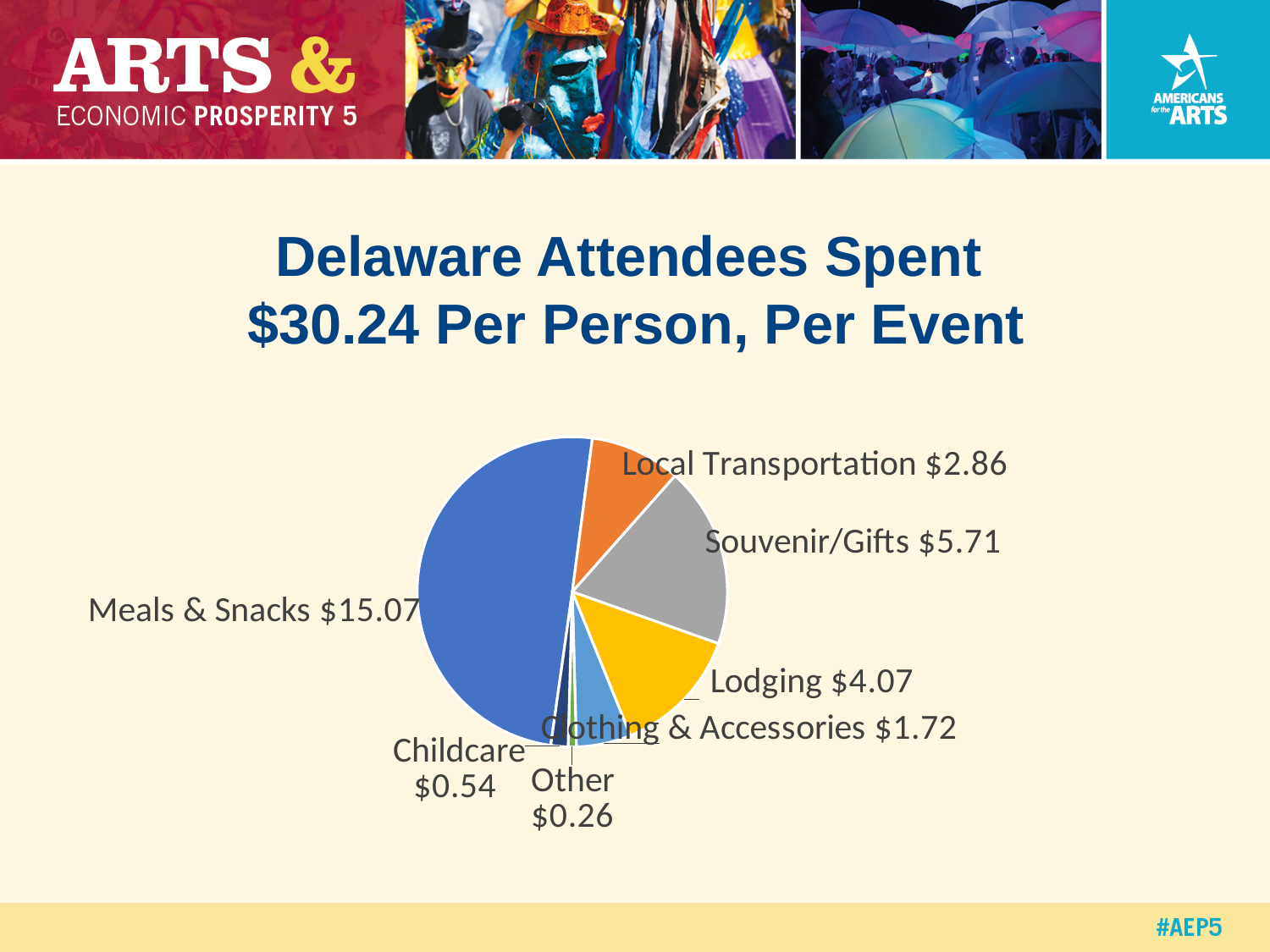
How many spending categories are shown in the pie chart? 7 What is the difference between spending on Meals & Snacks and Souvenir/Gifts? $9.36 According to the slide title, how much did Delaware attendees spend per person, per event? $30.24 What type of chart is shown on the slide? Pie chart Which spending category has the smallest slice of the pie? Other What is the value shown for Childcare? $0.54 Which spending category has the largest slice of the pie? Meals & Snacks Which is larger, spending on Lodging or on Local Transportation? Lodging What is the difference between spending on Souvenir/Gifts and Lodging? $1.64 How much did Delaware attendees spend on Meals & Snacks per person, per event? $15.07 What is the value shown for Lodging? $4.07 What is the value shown for Souvenir/Gifts? $5.71